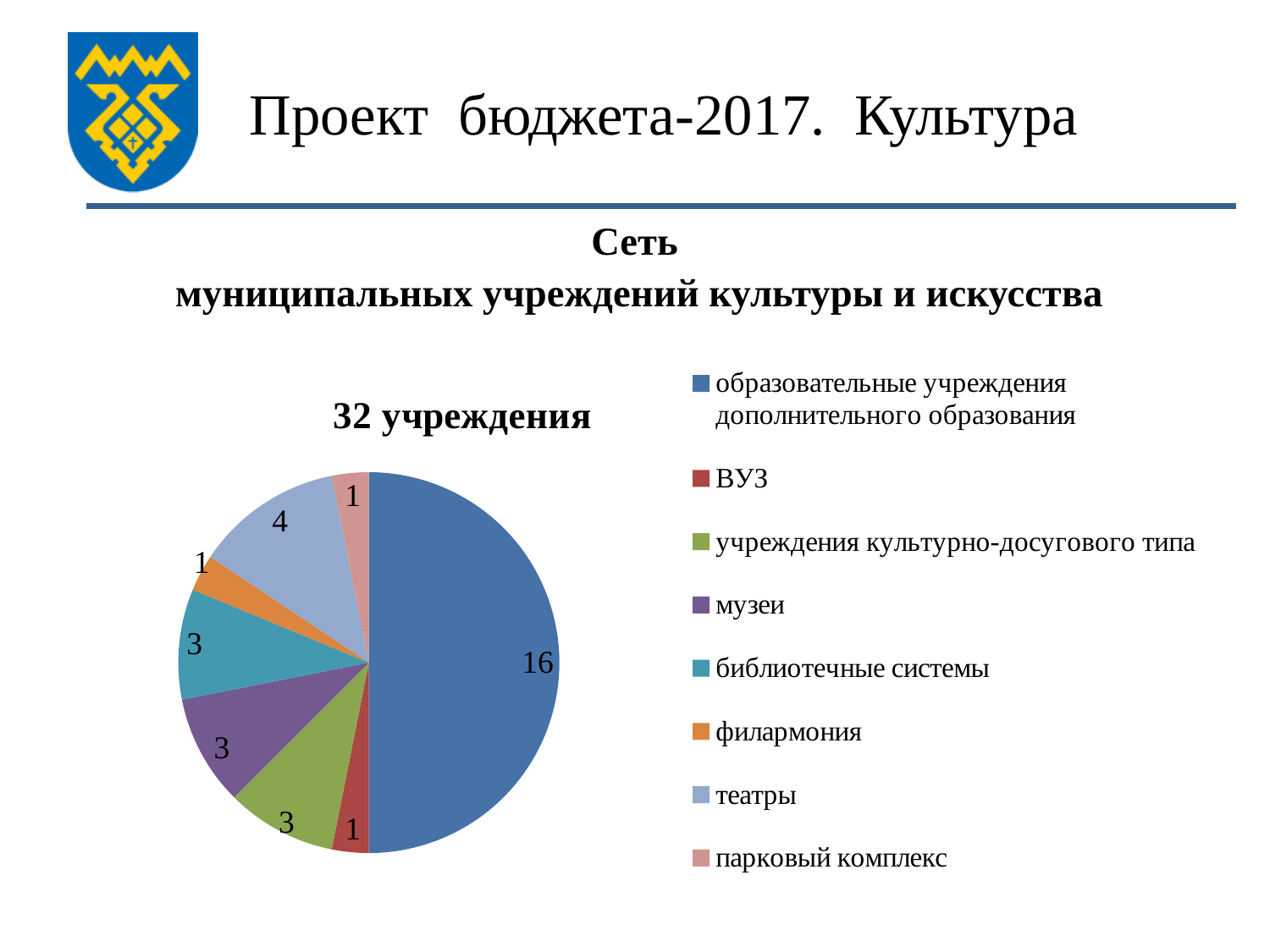
What kind of chart is shown on the slide? pie chart What is the value for театры? 4 What is the difference between the values for образовательные учреждения дополнительного образования and театры? 12 What share of the pie does образовательные учреждения дополнительного образования represent? 50% What is the value for библиотечные системы? 3 Which is larger, the value for театры or the value for музеи? театры How many slices does the pie chart have? 8 Which category has the largest slice of the pie? образовательные учреждения дополнительного образования What is the value for образовательные учреждения дополнительного образования? 16 What is the value for филармония? 1 How many entries does the legend list? 8 What is the title of the pie chart? 32 учреждения